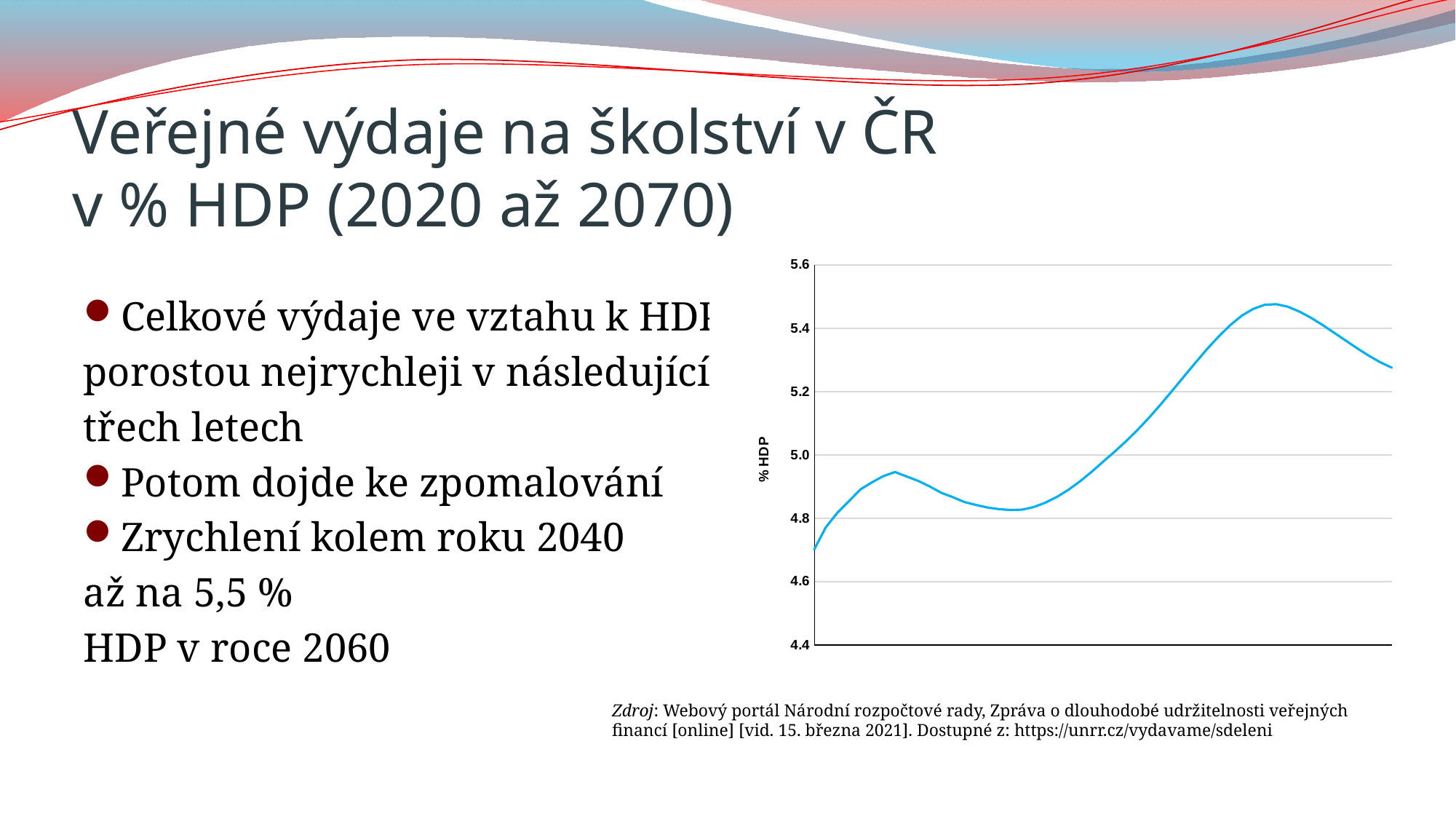
Overall, does the line rise or fall from its left end to its right end? rise Does the line rise or fall after reaching its peak near the right side of the chart? fall What is the label on the vertical axis of the chart? % HDP Is the value at the right end of the line greater or less than 5.2? greater What kind of chart is shown on the slide? line chart Is the peak value of the line greater or less than 5.4? greater What is the highest value shown on the vertical axis of the chart? 5.6 How many lines (series) are plotted on the chart? 1 Is the lowest point of the line greater or less than 4.6? greater Which is larger: the value at the left end of the line or the value at the right end of the line? the right end